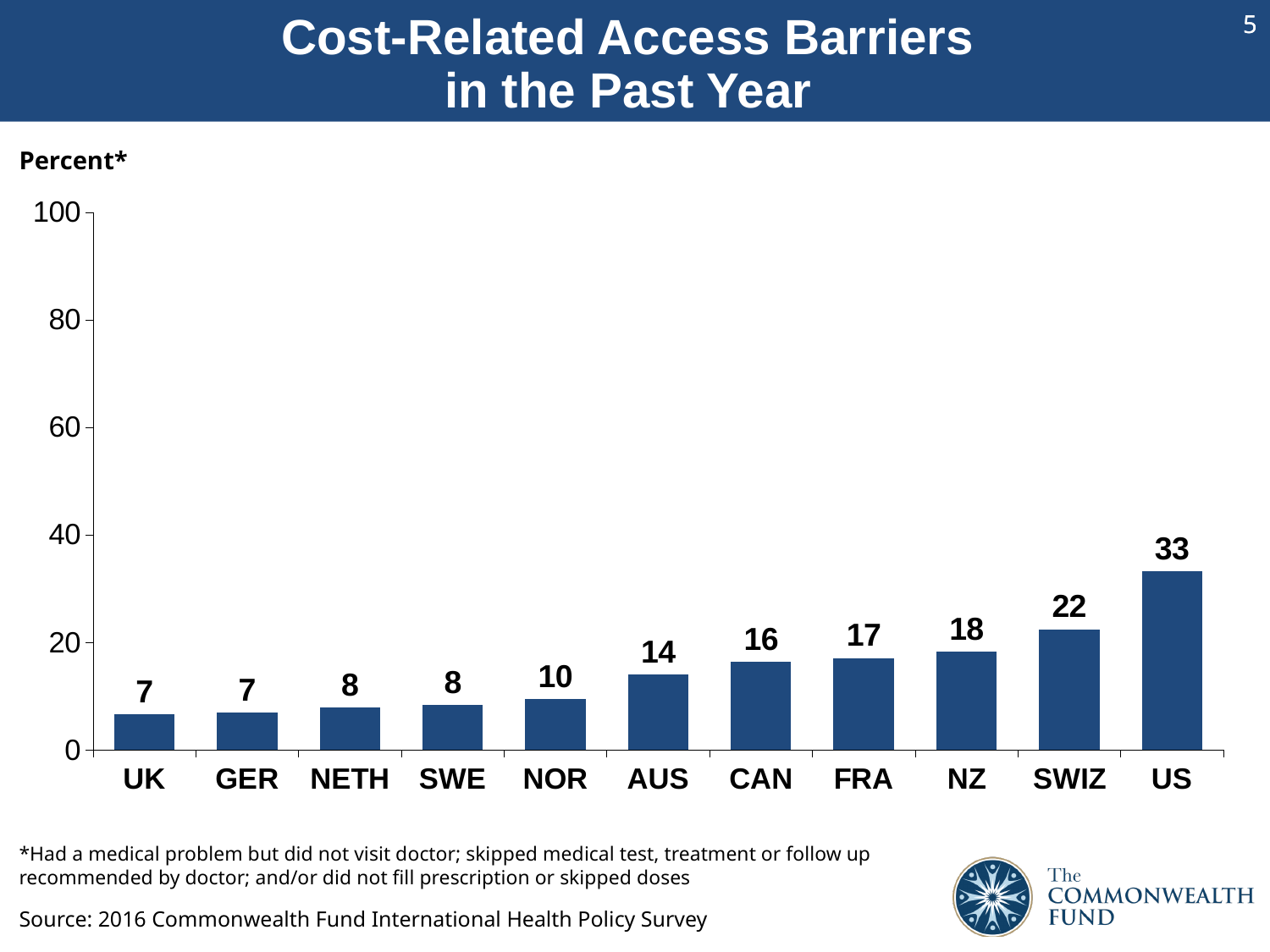
What is the title of the chart? Cost-Related Access Barriers in the Past Year What is the difference between the values for the US and SWIZ? 11 Which has a larger value, FRA or AUS? FRA What kind of chart is shown on the slide? bar chart Do the values rise or fall moving from left to right along the x axis? rise Is the value for the US greater or less than 40? less What is the value for CAN? 16 What is the difference between the values for NZ and UK? 11 Which country has the highest value? US What is the value for the US? 33 How many countries are shown on the chart? 11 What is the value for NOR? 10